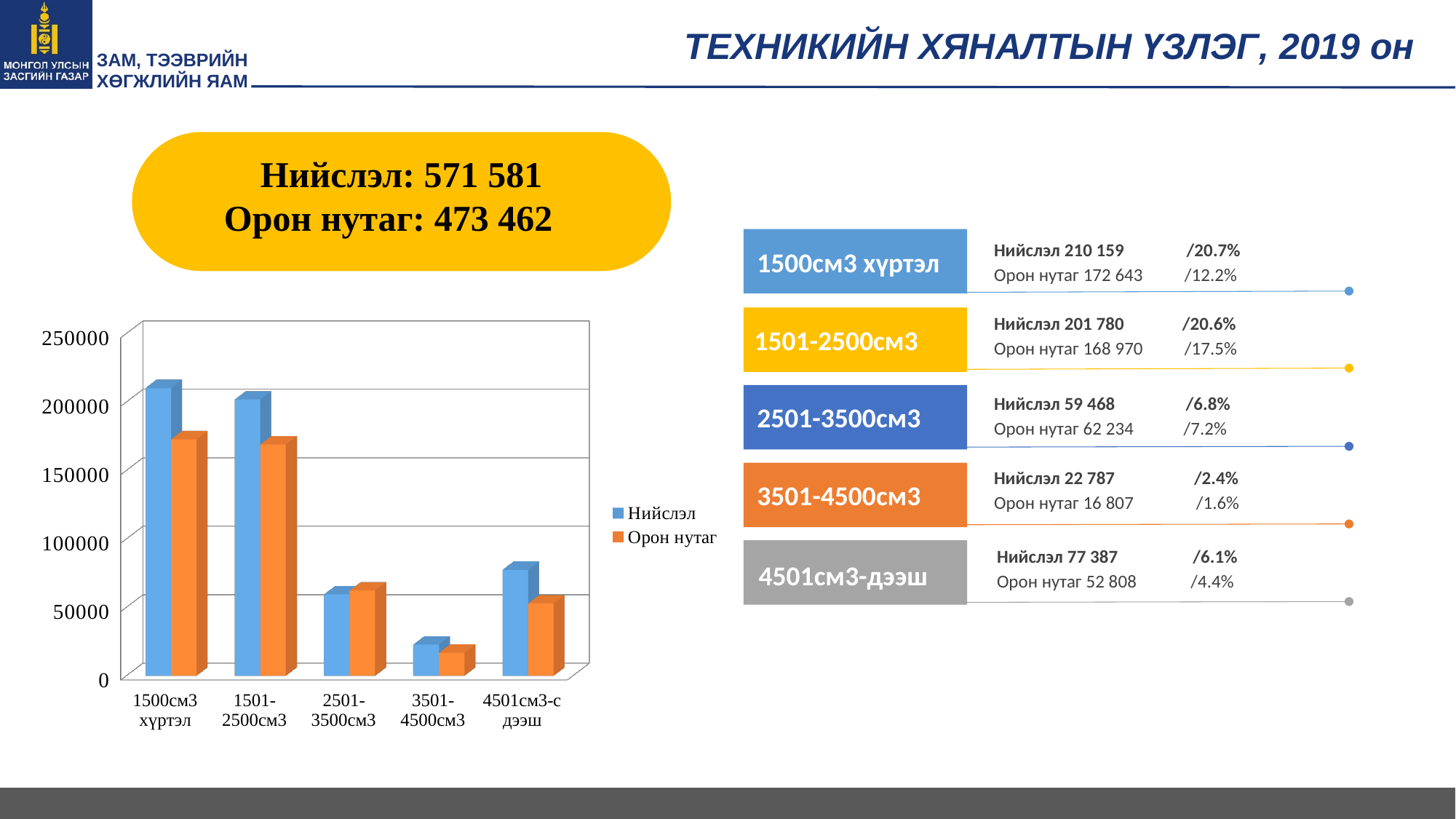
What is the difference between the Нийслэл and Орон нутаг values for the 1500см3 хүртэл category? 37 516 Is the Нийслэл value for 4501см3-с дээш greater or less than 100000? less Which category has the highest Нийслэл value? 1500см3 хүртэл Which category has the lowest Орон нутаг value? 3501-4500см3 Do the Нийслэл values rise or fall from 1500см3 хүртэл to 3501-4500см3? fall How many engine-size categories are shown on the x axis of the chart? 5 What is the Нийслэл value for the 1500см3 хүртэл category? 210 159 What is the Орон нутаг value for the 1501-2500см3 category? 168 970 What kind of chart is shown on the slide? Bar chart For the 2501-3500см3 category, which is larger: Нийслэл or Орон нутаг? Орон нутаг How many series does the chart legend list? 2 What are the two series named in the chart legend? Нийслэл and Орон нутаг